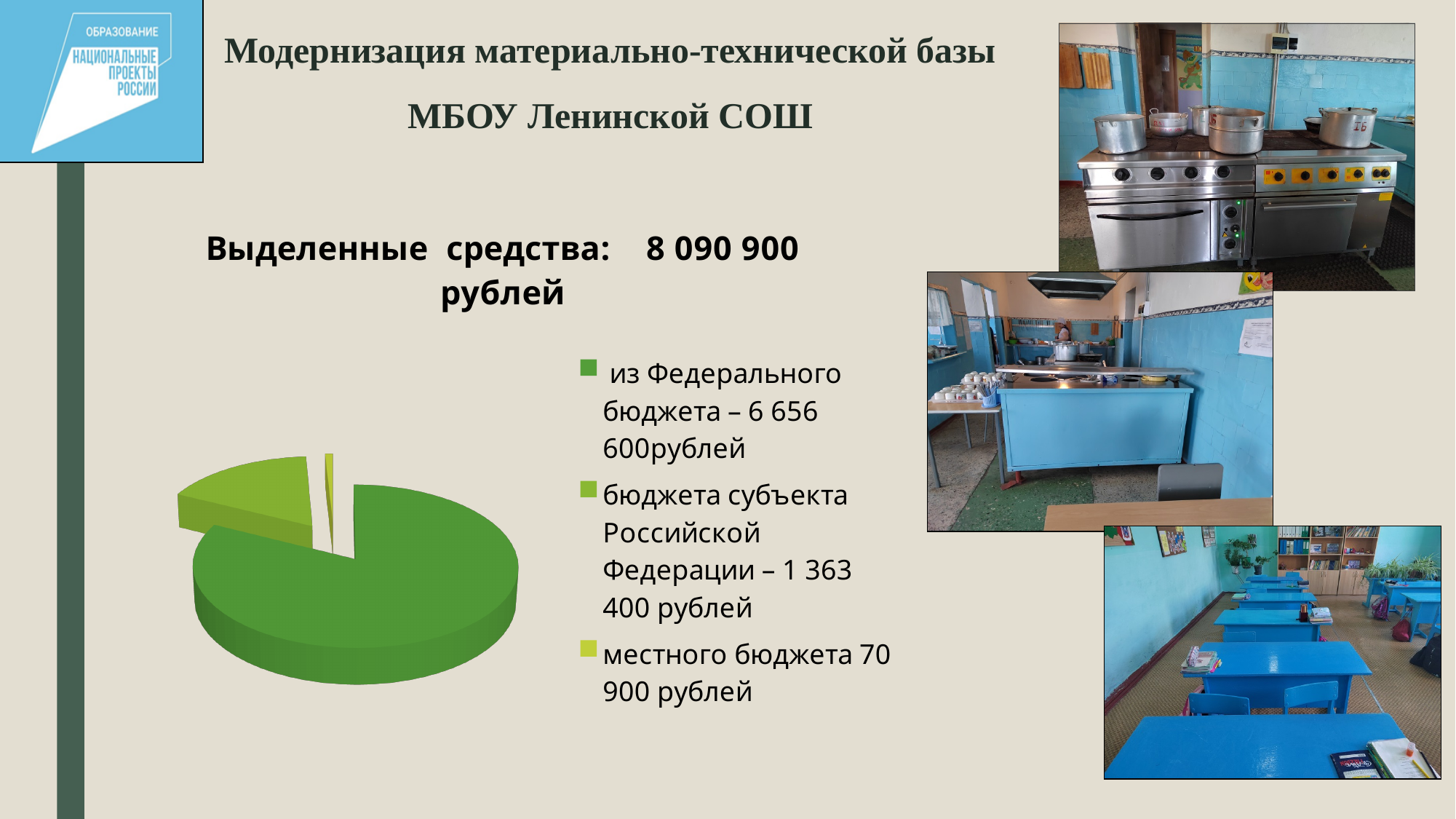
What is the difference between the funding from the budget of the subject of the Russian Federation and the local budget funding? 1 292 500 рублей What kind of chart is shown on the slide? Pie chart Which is larger: the funding from the budget of the subject of the Russian Federation or from the local budget? Бюджет субъекта Российской Федерации What is the difference between the Federal budget funding and the funding from the budget of the subject of the Russian Federation? 5 293 200 рублей What is the title at the top of the slide? Модернизация материально-технической базы МБОУ Ленинской СОШ How much funding came from the Federal budget (из Федерального бюджета)? 6 656 600 рублей How many slices does the pie chart have? 3 How much funding came from the budget of the subject of the Russian Federation (бюджета субъекта Российской Федерации)? 1 363 400 рублей How much funding came from the local budget (местного бюджета)? 70 900 рублей What is the total amount of allocated funds (Выделенные средства) shown on the slide? 8 090 900 рублей Which funding source accounts for the largest slice of the pie chart? Федеральный бюджет Which funding source accounts for the smallest slice of the pie chart? Местный бюджет